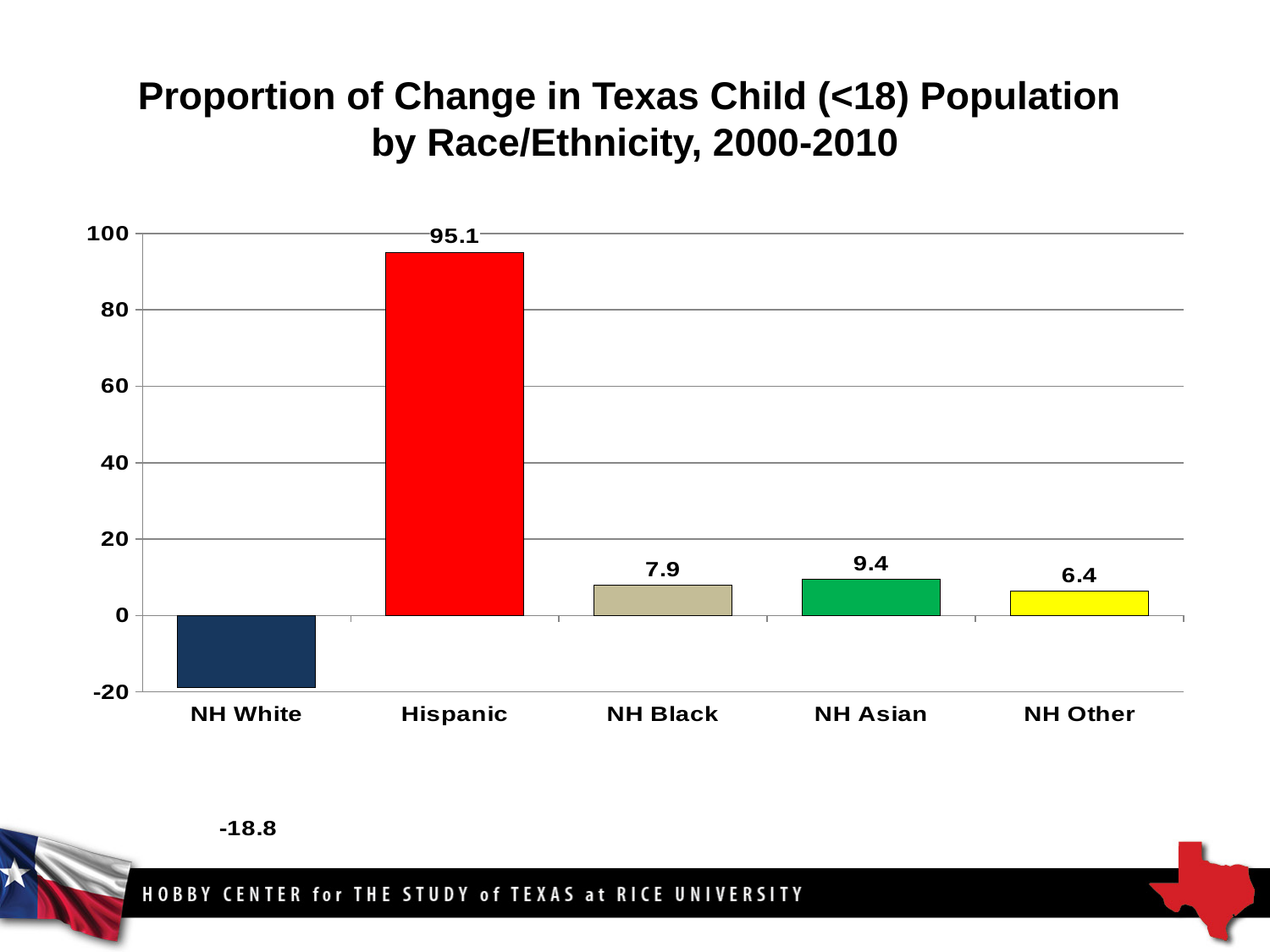
Is the value for Hispanic greater or less than 80? greater Which category has the lowest value? NH White What is the value for NH White? -18.8 How many categories are shown on the x axis? 5 Which is larger, the value for NH Asian or the value for NH Black? NH Asian What is the value for NH Other? 6.4 What is the value for NH Black? 7.9 Which category has the highest value? Hispanic What is the difference between the values for Hispanic and NH Asian? 85.7 What is the value for Hispanic? 95.1 What is the value for NH Asian? 9.4 What kind of chart is shown on the slide? bar chart